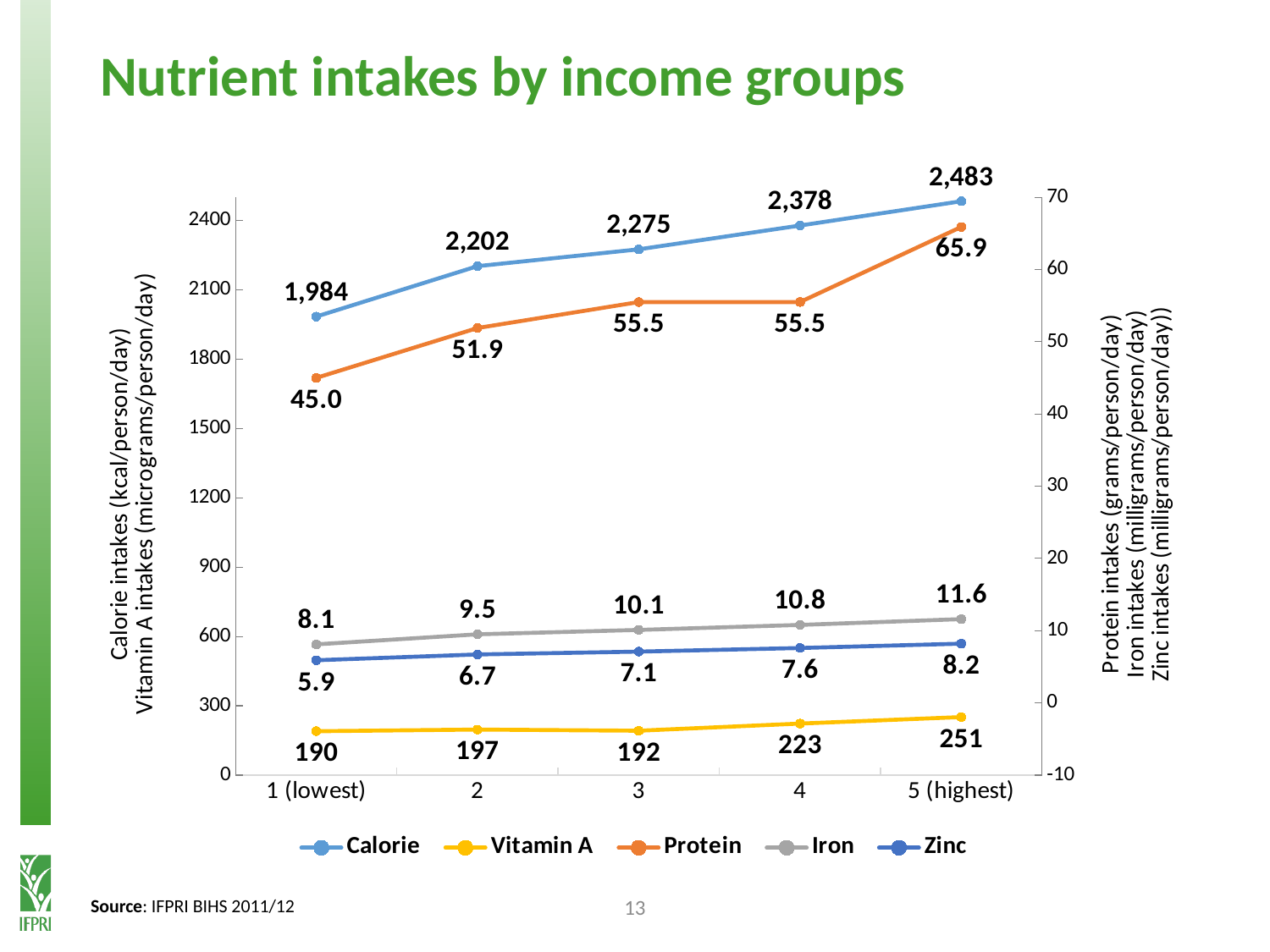
What is the Vitamin A intake for income group 4? 223 What is the calorie intake for income group 5 (highest)? 2,483 How many income groups are shown on the x axis? 5 What is the protein intake for income group 1 (lowest)? 45.0 What kind of chart is shown on the slide? Line chart How many series does the legend list? 5 Does calorie intake rise or fall from income group 1 (lowest) to income group 5 (highest)? Rise Which income group has the highest zinc intake? 5 (highest) What is the iron intake for income group 3? 10.1 What is the difference in calorie intake between income group 5 (highest) and income group 1 (lowest)? 499 Which income group has the lowest Vitamin A intake? 1 (lowest) Is the protein intake for income group 2 larger than for income group 5 (highest)? No